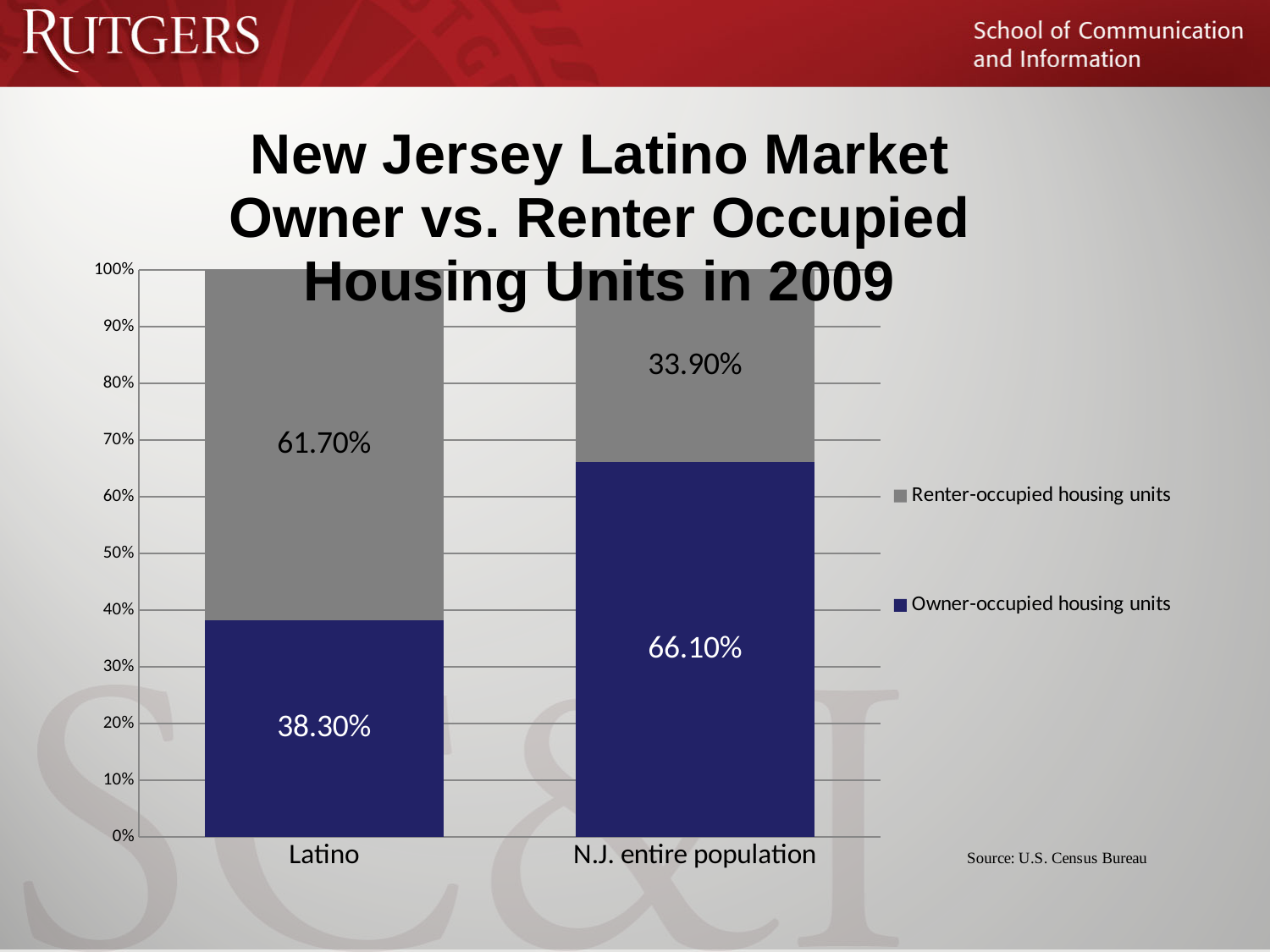
What percentage of Latino housing units are owner-occupied? 38.30% What is the source cited for the chart data? U.S. Census Bureau Which category has the higher share of owner-occupied housing units? N.J. entire population Which category has the lower share of renter-occupied housing units? N.J. entire population What kind of chart is shown on the slide? Stacked bar chart What percentage of housing units for the N.J. entire population are renter-occupied? 33.90% What is the difference in owner-occupied share between the N.J. entire population and Latino? 27.80% How many series does the legend list? 2 What percentage of Latino housing units are renter-occupied? 61.70% What percentage of housing units for the N.J. entire population are owner-occupied? 66.10% How many categories are shown on the x axis? 2 Is the renter-occupied share larger for Latino or for the N.J. entire population? Latino